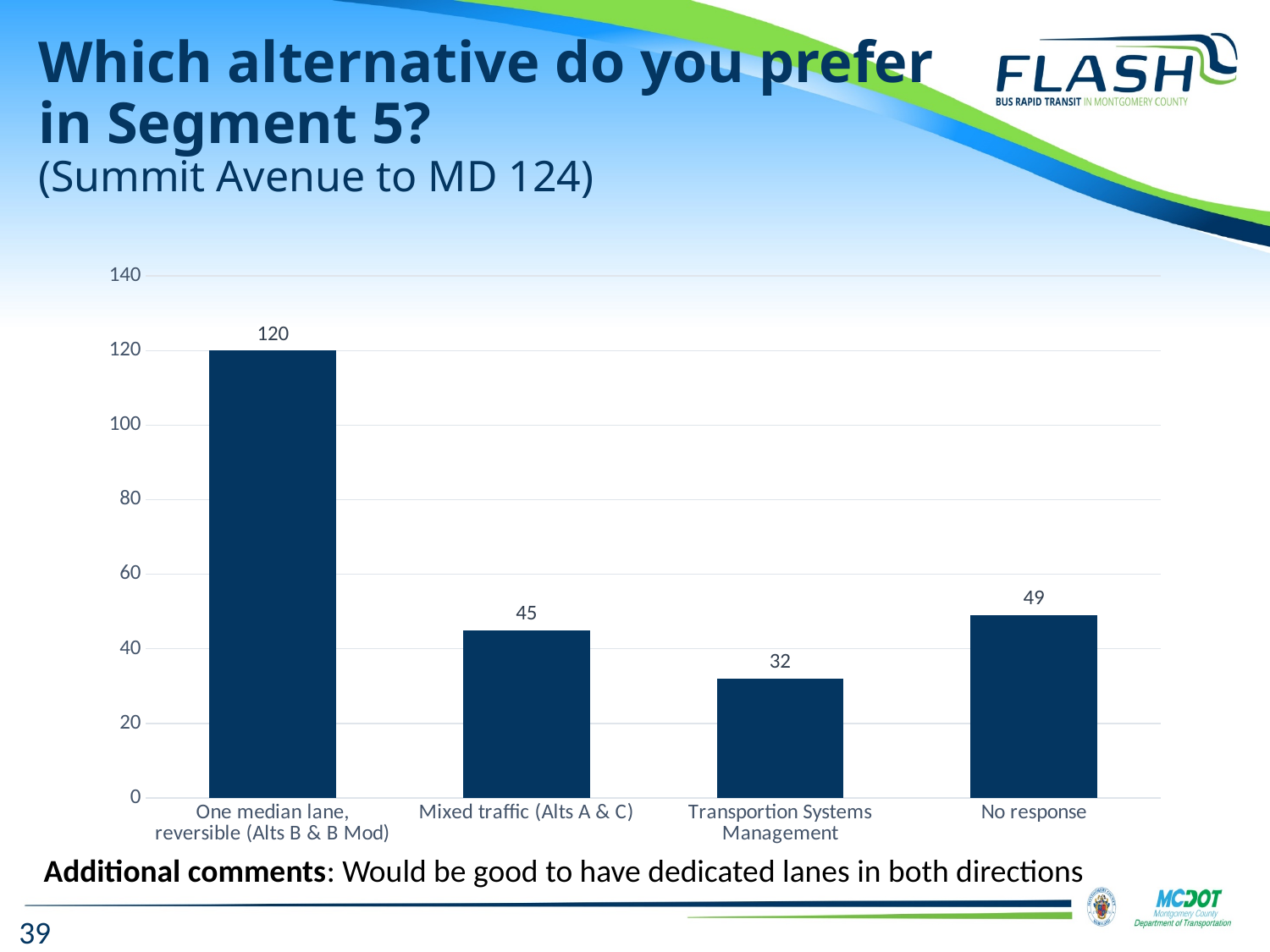
What is the value for "No response"? 49 What is the difference between the values for "One median lane, reversible (Alts B & B Mod)" and "Mixed traffic (Alts A & C)"? 75 Which category has the lowest value? Transportion Systems Management What is the difference between the values for "No response" and "Transportion Systems Management"? 17 What is the value for "One median lane, reversible (Alts B & B Mod)"? 120 How many categories are shown on the x axis? 4 Which is larger, the value for "No response" or the value for "Mixed traffic (Alts A & C)"? No response What is the value for "Transportion Systems Management"? 32 Which category has the highest value? One median lane, reversible (Alts B & B Mod) What is the value for "Mixed traffic (Alts A & C)"? 45 What kind of chart is shown on the slide? bar chart Is the value for "Transportion Systems Management" greater or less than 40? less